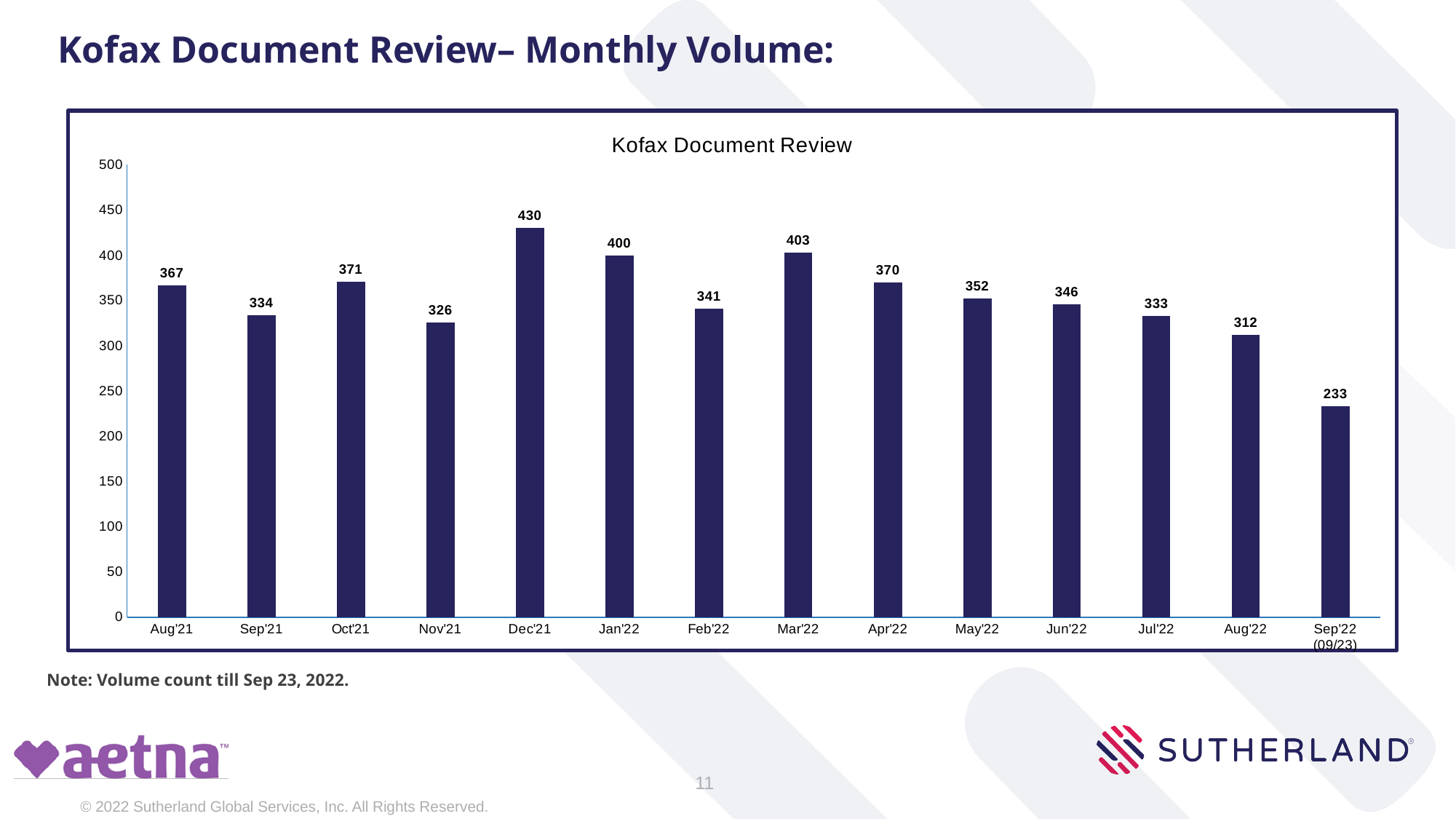
What kind of chart is shown on the slide? Bar chart What is the difference between the Aug'22 volume and the Sep'22 volume? 79 What is the volume shown for Sep'22 (09/23)? 233 What is the title shown inside the chart area? Kofax Document Review Which month has the lowest volume? Sep'22 (09/23) Is the value for Feb'22 greater or less than 300? greater Which month has the highest volume? Dec'21 What is the volume shown for Nov'21? 326 What is the difference between the Dec'21 volume and the Jan'22 volume? 30 What is the Kofax Document Review volume for Dec'21? 430 Which month has a larger volume, Mar'22 or Apr'22? Mar'22 How many months are shown on the x axis? 14